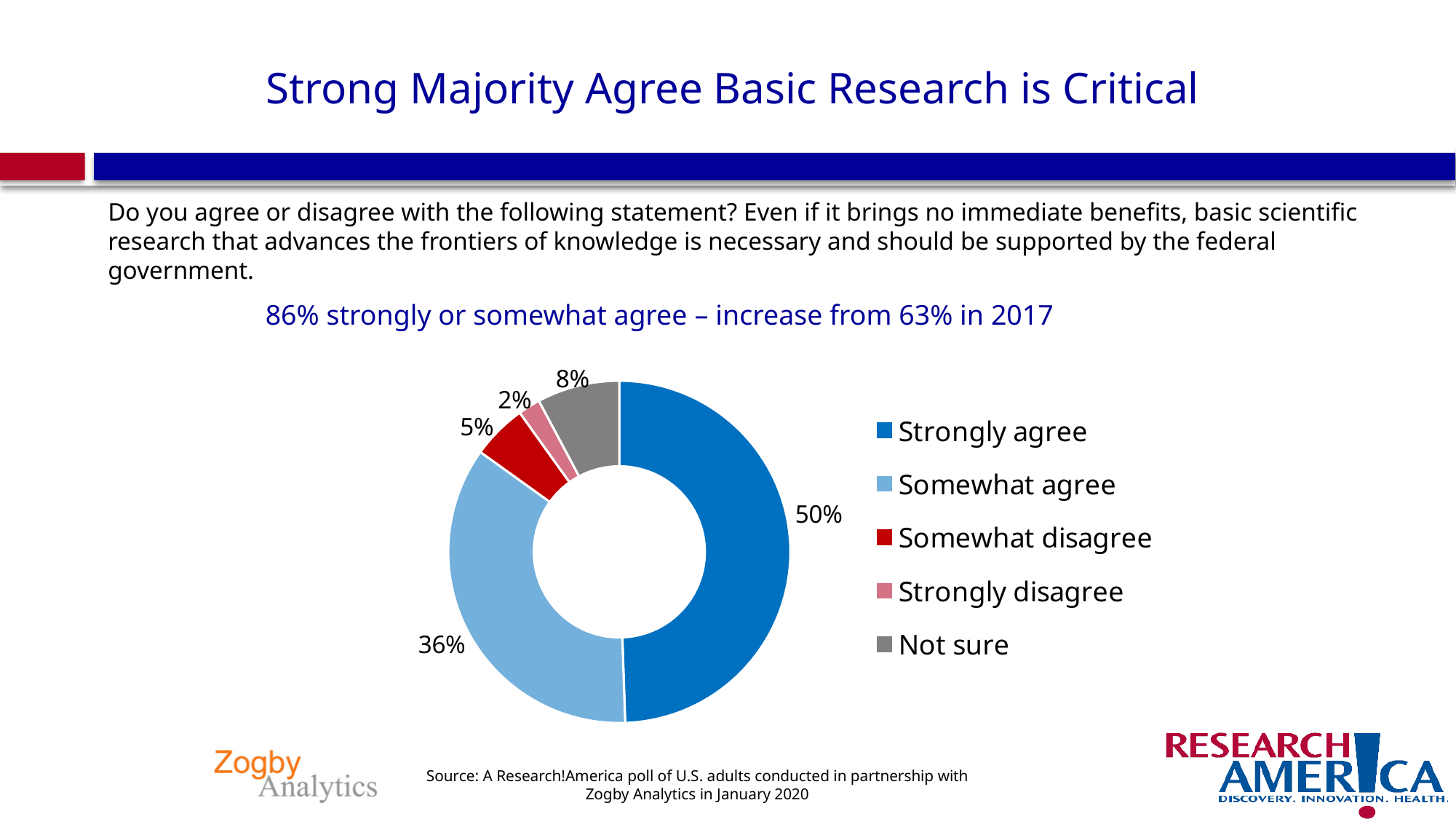
Which is larger, the share for Not sure or the share for Somewhat disagree? Not sure What is the difference in percentage points between Strongly agree and Somewhat agree? 14 How many response categories does the chart show? 5 What percentage of respondents somewhat agree? 36% What percentage of respondents somewhat disagree? 5% What colour represents Somewhat disagree in the chart? Red What kind of chart is shown on the slide? Doughnut (pie) chart Which response category has the largest share? Strongly agree What percentage of respondents are not sure? 8% Which response category has the smallest share? Strongly disagree What percentage of respondents strongly disagree? 2% What percentage of respondents strongly agree? 50%